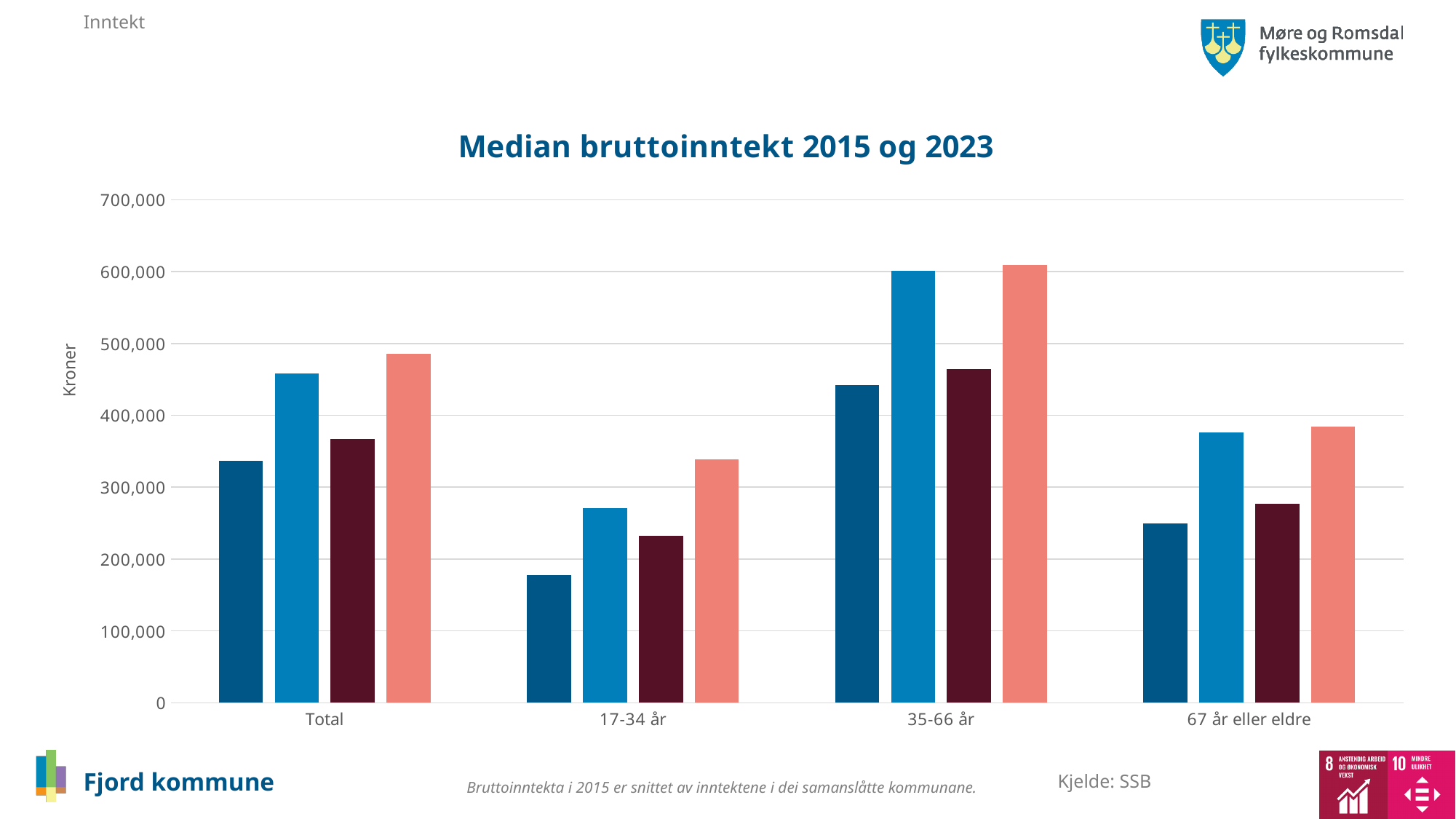
Is the value of the third (dark red) bar for 67 år eller eldre greater or less than 300,000? less Which category contains the shortest bar in the chart? 17-34 år What is the title of the chart? Median bruttoinntekt 2015 og 2023 What is the label on the vertical axis of the chart? Kroner Which category contains the tallest bar in the chart? 35-66 år Is the value of the first (dark blue) bar for 17-34 år greater or less than 200,000? less Is the value of the fourth (salmon) bar for Total greater or less than 400,000? greater How many categories are shown along the x axis of the chart? 4 What kind of chart is shown on the slide? bar chart How many bars are plotted for each category in the chart? 4 Which is larger: the first (dark blue) bar for Total or the first (dark blue) bar for 67 år eller eldre? Total